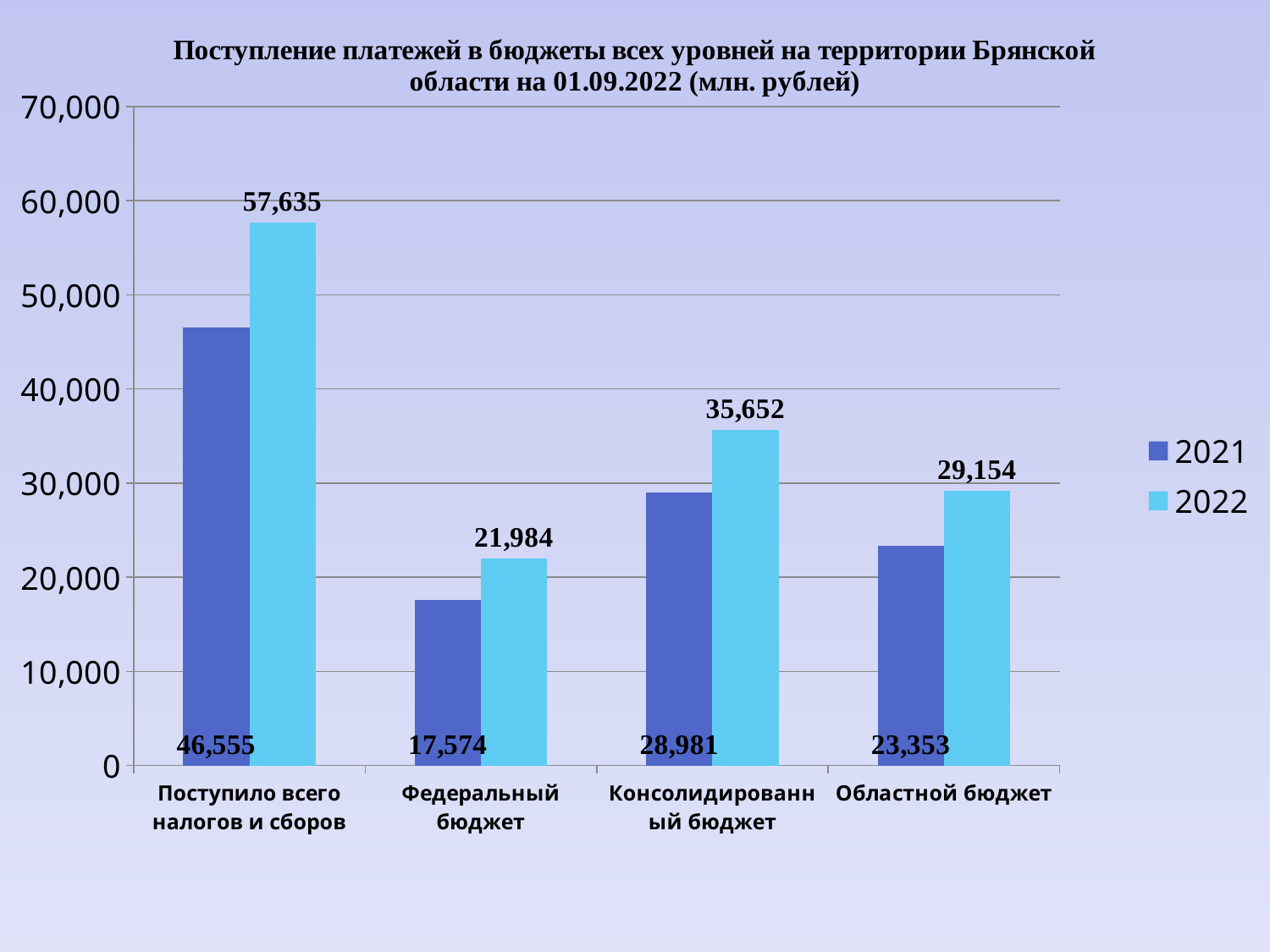
What is the 2021 value for Областной бюджет? 23,353 Which category has the lowest 2022 value? Федеральный бюджет What is the difference between the 2022 and 2021 values for Областной бюджет? 5,801 What is the 2022 value for Поступило всего налогов и сборов? 57,635 Which is larger for Консолидированный бюджет: the 2021 value or the 2022 value? 2022 How many categories are shown on the x axis? 4 What is the difference between the 2022 and 2021 values for Поступило всего налогов и сборов? 11,080 Which category has the highest 2021 value? Поступило всего налогов и сборов How many series does the legend list? 2 What is the 2021 value for Федеральный бюджет? 17,574 What is the 2022 value for Консолидированный бюджет? 35,652 What kind of chart is shown on the slide? Bar chart